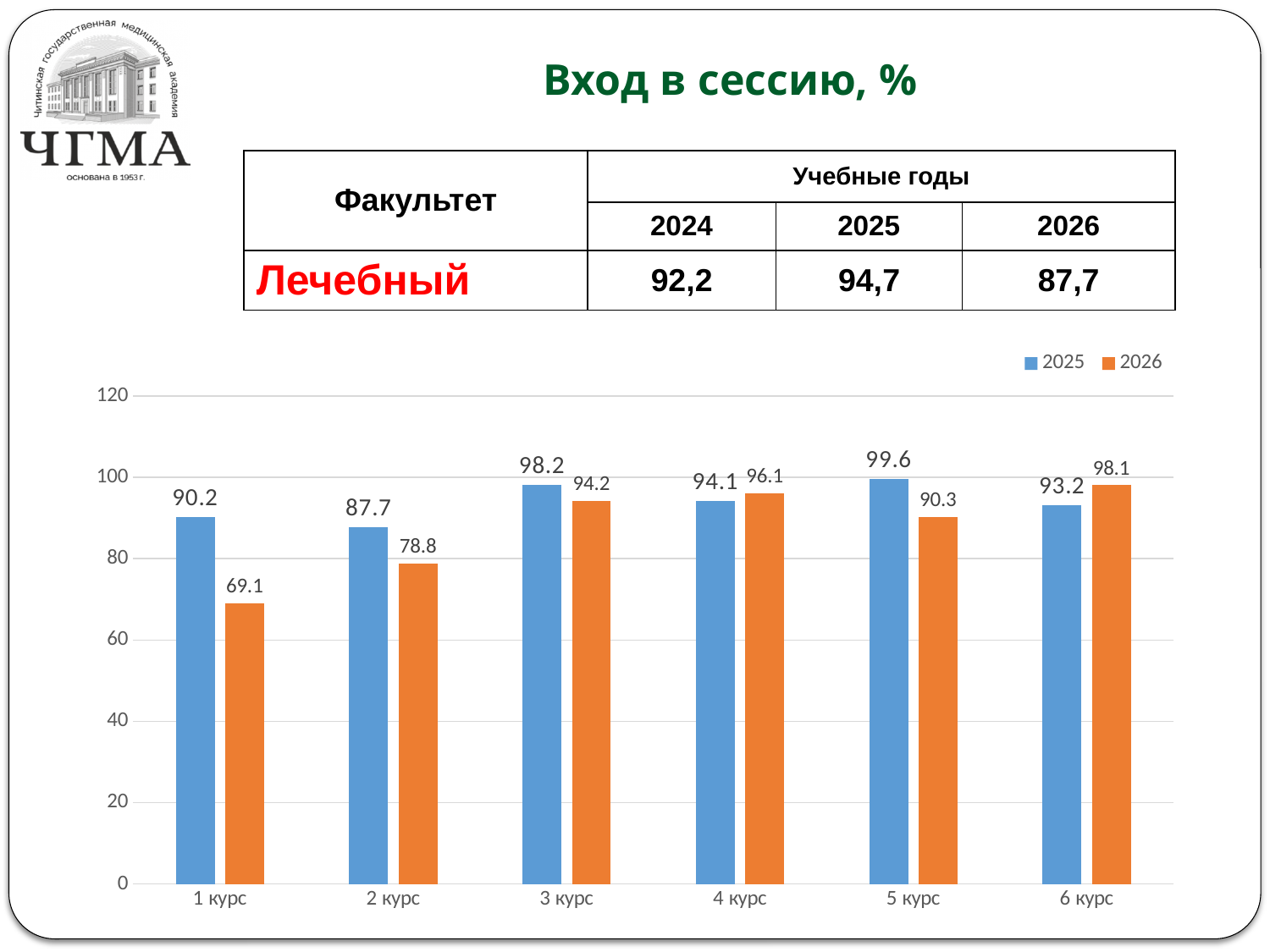
What is the value for 2026 at 2 курс? 78.8 What is the value for 2025 at 1 курс? 90.2 What is the difference between the 2026 and 2025 values at 6 курс? 4.9 What type of chart is shown on the slide? bar chart What is the value for 2026 at 6 курс? 98.1 How many course categories are shown on the x axis of the chart? 6 How many series does the chart legend list? 2 Which course has the lowest value for the 2026 series? 1 курс Which course has the highest value for the 2025 series? 5 курс At 4 курс, which series has the larger value, 2025 or 2026? 2026 Is the value for 2026 at 1 курс greater or less than 80? less What is the difference between the 2025 and 2026 values at 1 курс? 21.1